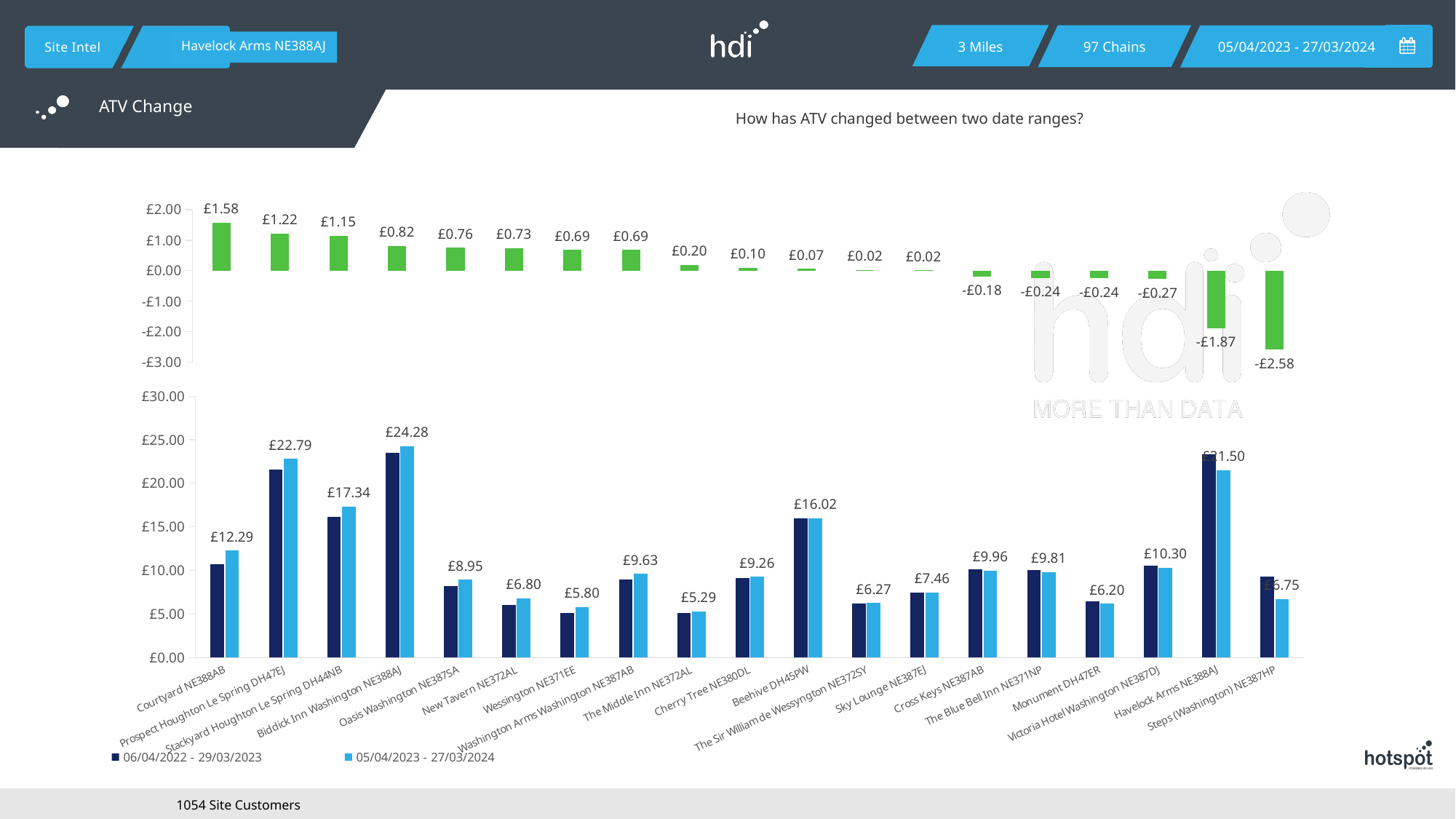
On the bottom chart, what is the value for Biddick Inn Washington NE388AJ in the 05/04/2023 - 27/03/2024 series? £24.28 On the bottom chart, which has the larger 05/04/2023 - 27/03/2024 value: Prospect Houghton Le Spring DH47EJ or Stackyard Houghton Le Spring DH44NB? Prospect Houghton Le Spring DH47EJ On the bottom chart, which category has the highest value in the 05/04/2023 - 27/03/2024 series? Biddick Inn Washington NE388AJ On the bottom chart, what is the value for The Middle Inn NE372AL in the 05/04/2023 - 27/03/2024 series? £5.29 What is the lowest value shown on the top chart? -£2.58 How many categories are shown on the bottom chart? 19 What is the highest value shown on the top chart? £1.58 On the bottom chart, what is the difference between the 05/04/2023 - 27/03/2024 values for Biddick Inn Washington NE388AJ and Prospect Houghton Le Spring DH47EJ? £1.49 How many series does the legend of the bottom chart list? 2 On the bottom chart, which category has the lowest value in the 05/04/2023 - 27/03/2024 series? The Middle Inn NE372AL On the bottom chart, is the 06/04/2022 - 29/03/2023 value for Havelock Arms NE388AJ greater or less than £20.00? greater On the bottom chart, what is the value for Beehive DH45PW in the 05/04/2023 - 27/03/2024 series? £16.02